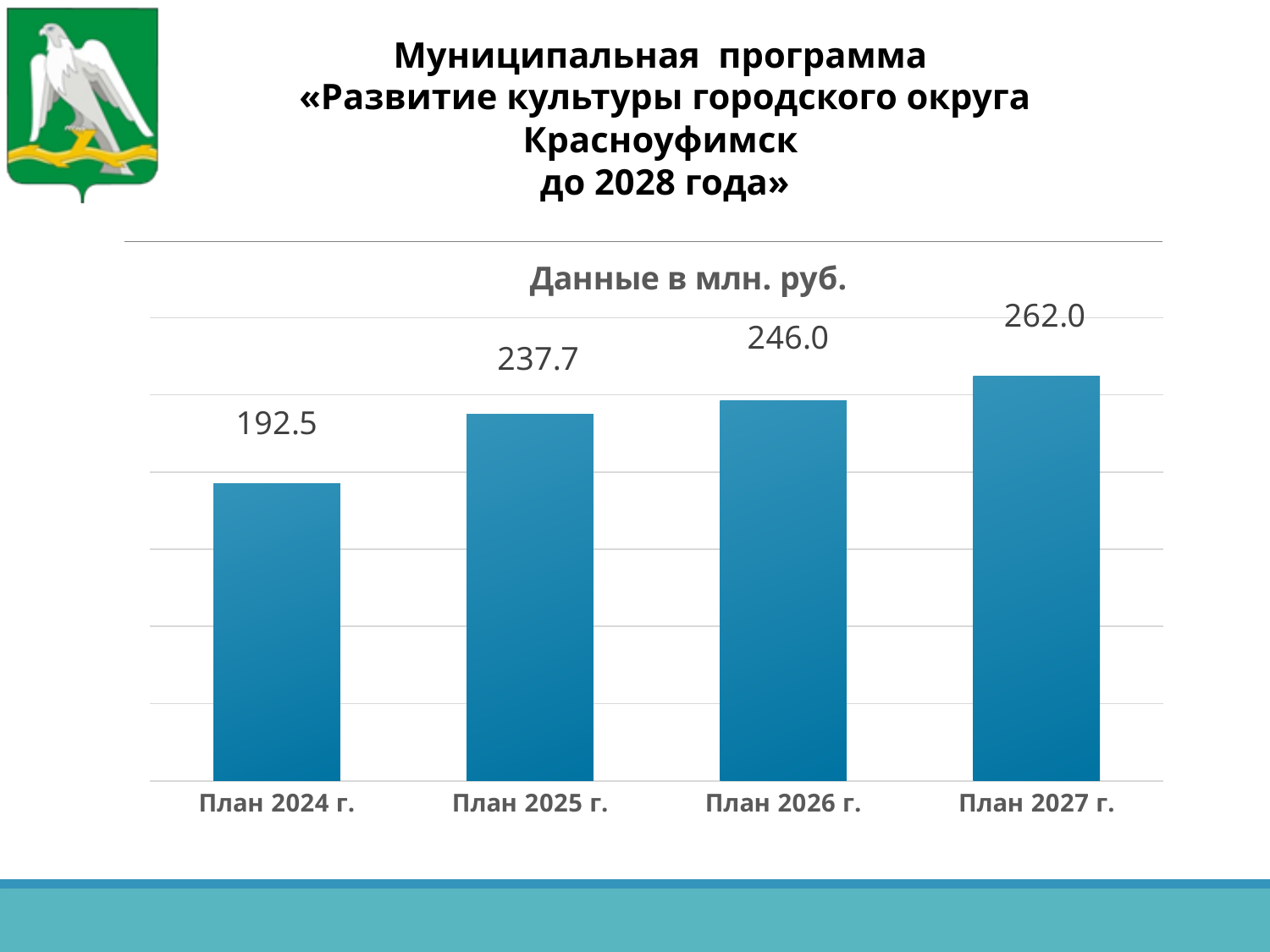
Which category has the highest value? План 2027 г. What is the value for План 2024 г.? 192.5 What is the difference between the values for План 2025 г. and План 2024 г.? 45.2 How many categories are shown on the chart? 4 Do the values rise or fall from План 2024 г. to План 2027 г.? Rise What kind of chart is shown on the slide? Bar chart What is the difference between the values for План 2027 г. and План 2024 г.? 69.5 What is the value for План 2027 г.? 262.0 What is the value for План 2026 г.? 246.0 What is the value for План 2025 г.? 237.7 Which is larger, the value for План 2026 г. or the value for План 2025 г.? План 2026 г. Which category has the lowest value? План 2024 г.